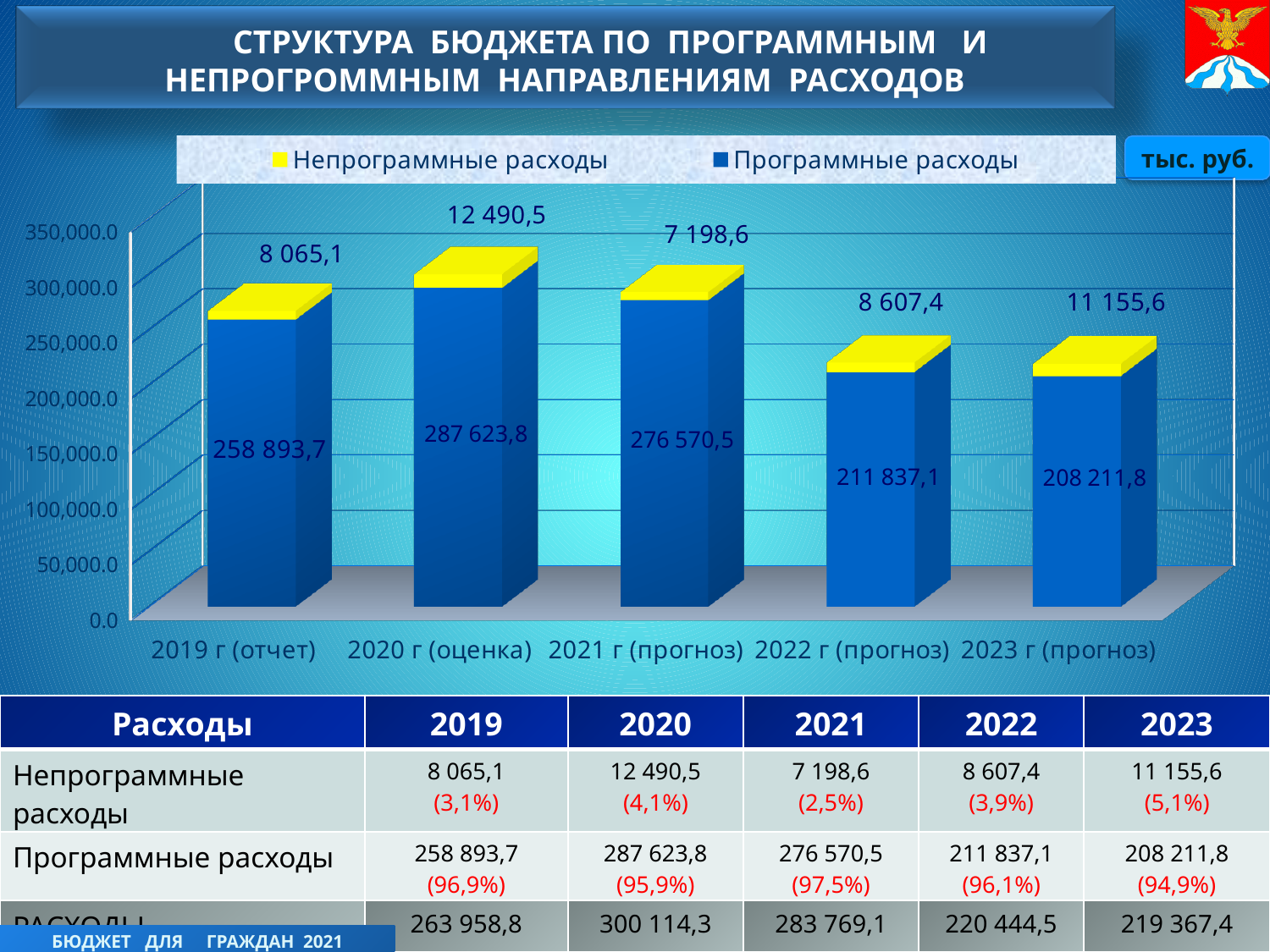
What is the value of Программные расходы for 2020 г (оценка)? 287 623,8 Which year has the lowest value of Непрограммные расходы? 2021 г (прогноз) How many years are shown on the x axis of the chart? 5 Which year has the highest value of Программные расходы? 2020 г (оценка) What kind of chart is shown on the slide? stacked bar chart What is the total of the stacked bar for 2019 г (отчет)? 266 958,8 What is the difference between Программные расходы in 2021 г (прогноз) and 2022 г (прогноз)? 64 733,4 What is the value of Непрограммные расходы for 2019 г (отчет)? 8 065,1 Is the value of Программные расходы for 2023 г (прогноз) greater or less than 250,000.0? less What is the value of Непрограммные расходы for 2023 г (прогноз)? 11 155,6 Which is larger: Непрограммные расходы in 2020 г (оценка) or in 2022 г (прогноз)? 2020 г (оценка) How many series does the chart legend list? 2